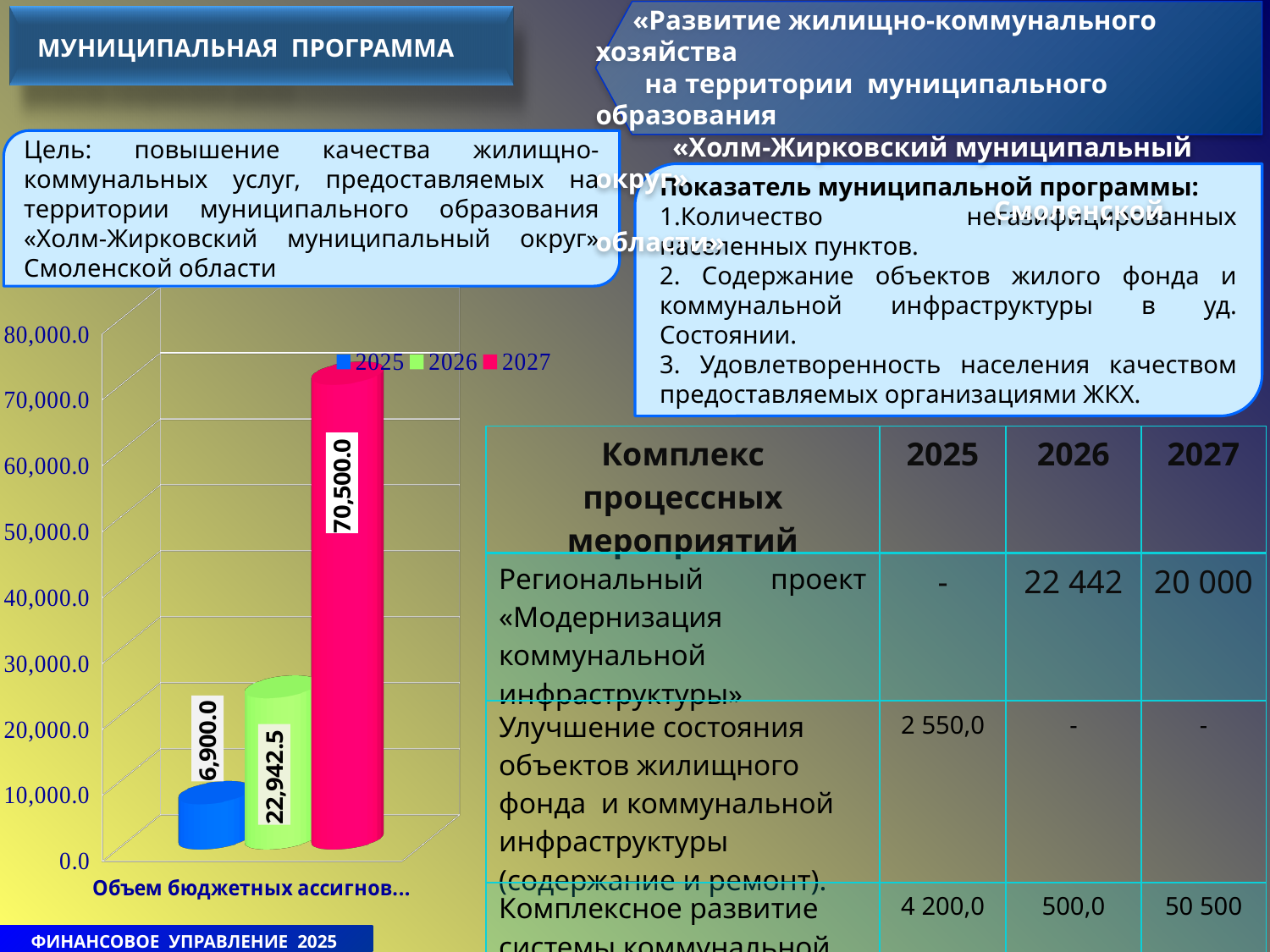
What is the difference between the 2027 and 2026 values in the bar chart? 47,557.5 What is the value shown for 2026 in the bar chart? 22,942.5 Which year has the highest value in the bar chart? 2027 What kind of chart is shown on the slide? bar chart What is the value shown for 2027 in the bar chart? 70,500.0 Do the values in the bar chart rise or fall from 2025 to 2027? rise How many series does the legend of the bar chart list? 3 Is the value for 2027 in the bar chart greater or less than 60,000.0? greater What is the difference between the 2026 and 2025 values in the bar chart? 16,042.5 Which year has the lowest value in the bar chart? 2025 What is the value shown for 2025 in the bar chart? 6,900.0 Which is larger in the bar chart, the value for 2025 or the value for 2026? 2026